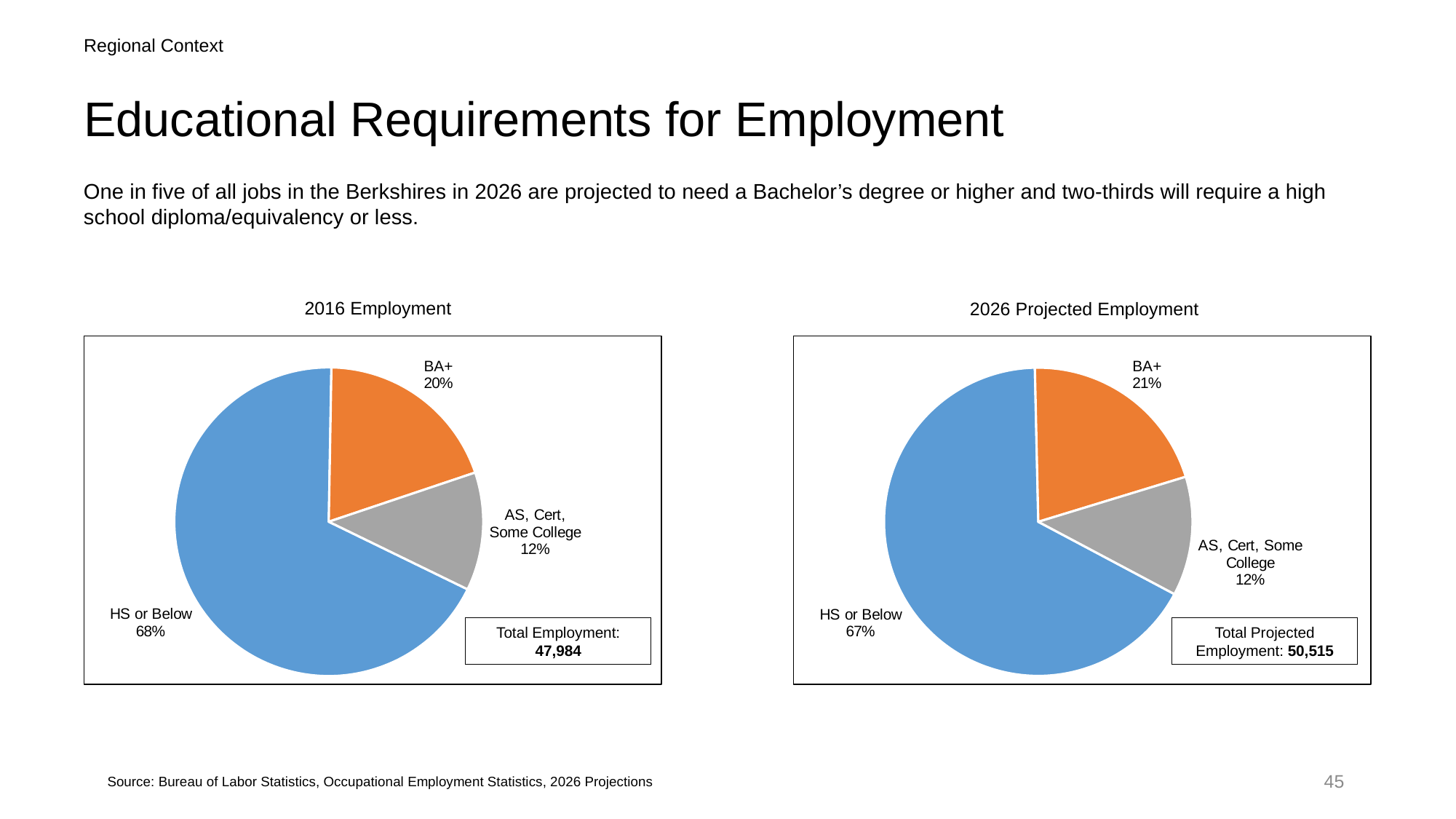
In the 2016 Employment chart, what share of employment is HS or Below? 68% In the 2026 Projected Employment chart, which category has the largest slice? HS or Below In the 2026 Projected Employment chart, what share of employment is AS, Cert, Some College? 12% What is the total projected employment shown in the 2026 Projected Employment chart? 50,515 In the 2026 Projected Employment chart, what share of employment is BA+? 21% In the 2016 Employment chart, what is the difference in percentage points between HS or Below and BA+? 48 In the 2016 Employment chart, what share of employment is BA+? 20% In the 2016 Employment chart, which category has the smallest slice? AS, Cert, Some College In the 2026 Projected Employment chart, which is larger, BA+ or AS, Cert, Some College? BA+ How many slices does the 2016 Employment pie chart have? 3 What is the total employment shown in the 2016 Employment chart? 47,984 What type of chart is the 2026 Projected Employment chart? Pie chart